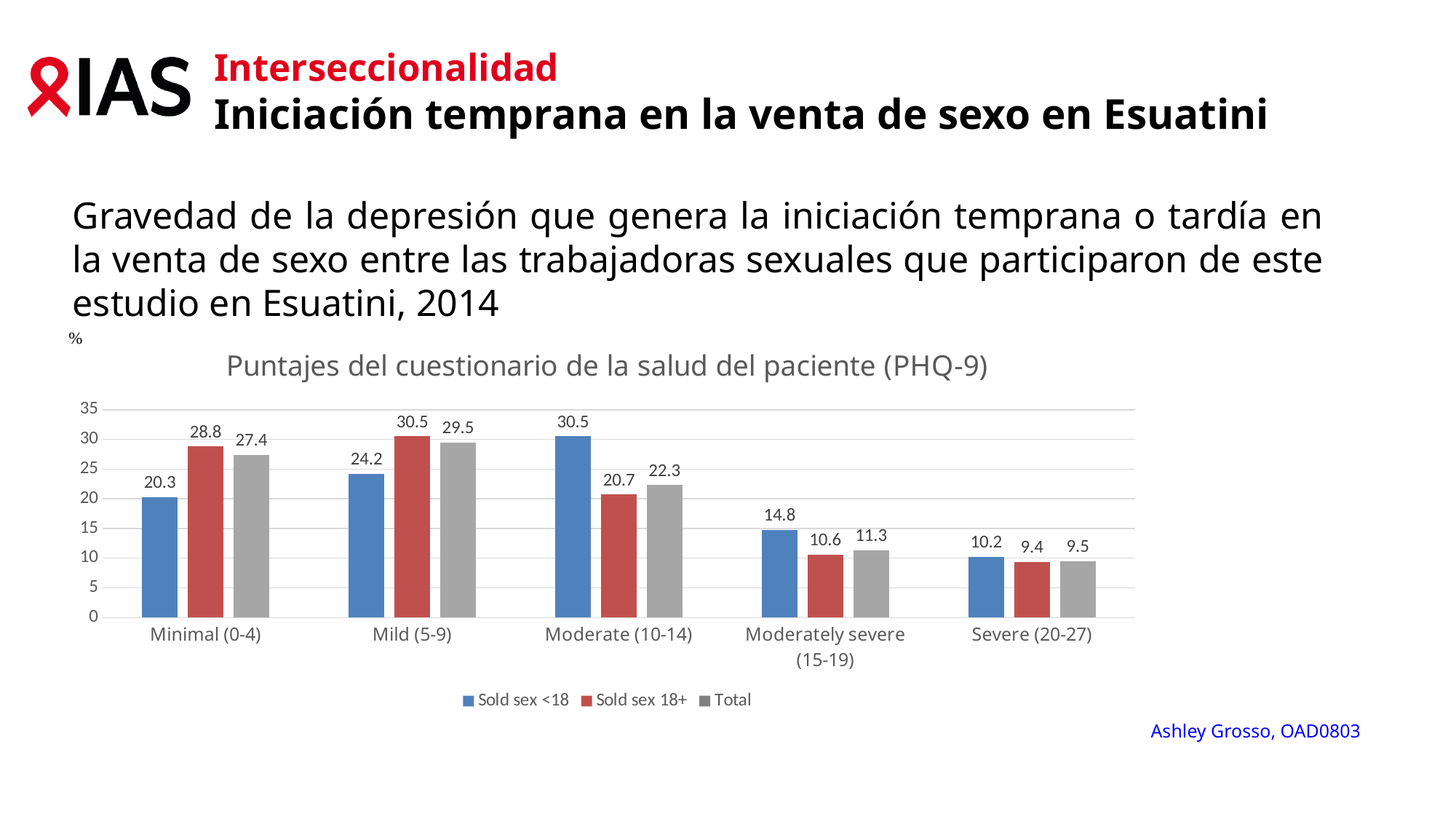
What is the value for 'Sold sex <18' in the Moderate (10-14) category? 30.5 Which category has the lowest value for the 'Sold sex <18' series? Severe (20-27) What is the Total value for the Severe (20-27) category? 9.5 How many series does the legend list? 3 How many categories are shown on the x axis? 5 What is the difference between 'Sold sex <18' and 'Sold sex 18+' in the Moderate (10-14) category? 9.8 What is the value for 'Sold sex 18+' in the Minimal (0-4) category? 28.8 In the Minimal (0-4) category, which is larger: 'Sold sex <18' or 'Sold sex 18+'? Sold sex 18+ Which category has the highest value for the 'Sold sex 18+' series? Mild (5-9) Is the Total value for Moderately severe (15-19) greater or less than 15? less What kind of chart is shown on the slide? Bar chart What is the title of the chart? Puntajes del cuestionario de la salud del paciente (PHQ-9)